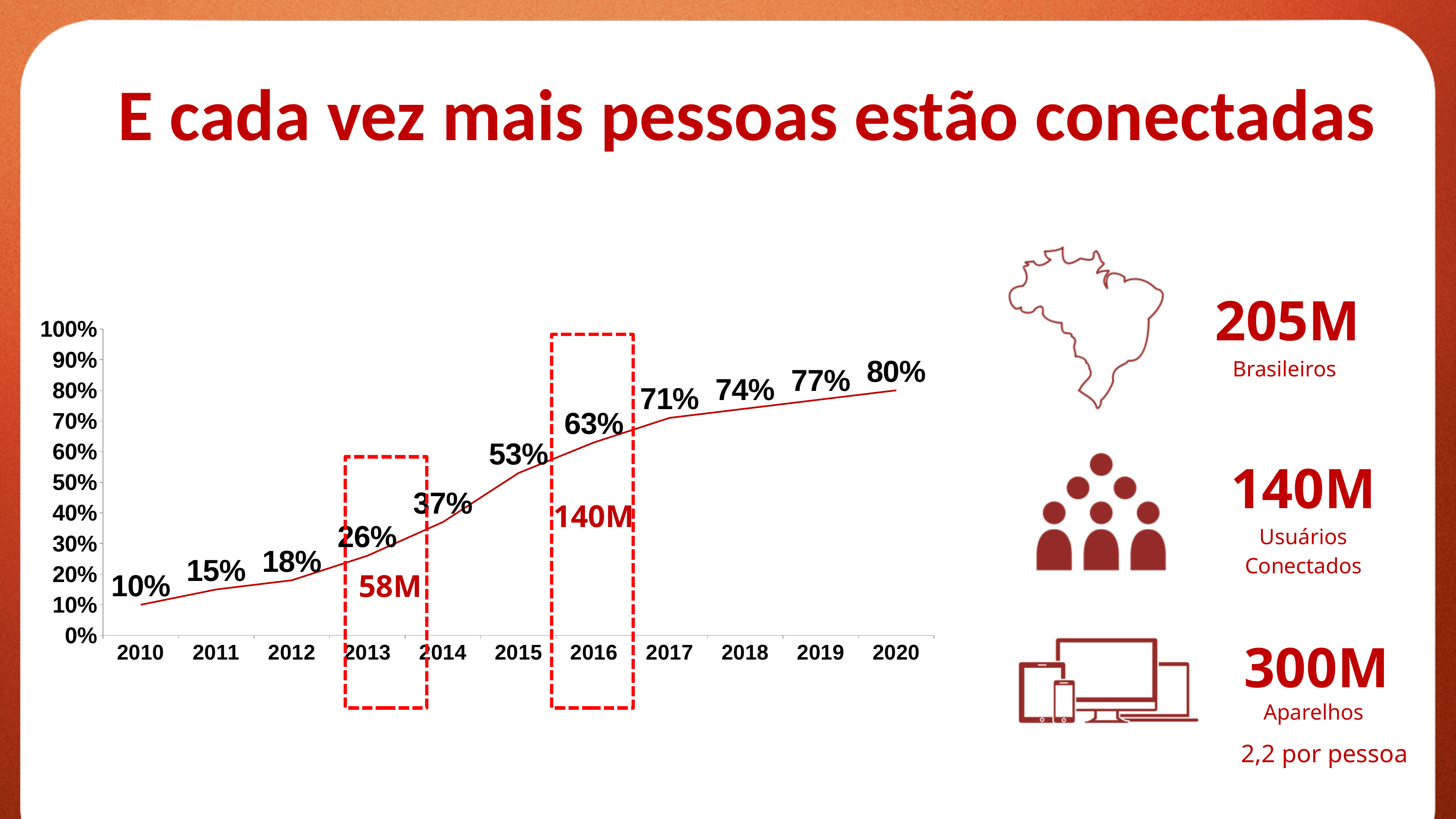
What is the value for 2010? 10% What is the difference between the values for 2015 and 2014? 16% What kind of chart is shown on the slide? line chart What is the difference between the values for 2020 and 2010? 70% What is the value for 2016? 63% What is the value for 2020? 80% Which year has the highest value? 2020 Which year has the lowest value? 2010 What label is shown in the dashed red box at 2013? 58M How many years are plotted on the x axis? 11 Do the values rise or fall from 2010 to 2020? rise Which is larger, the value for 2013 or the value for 2017? 2017